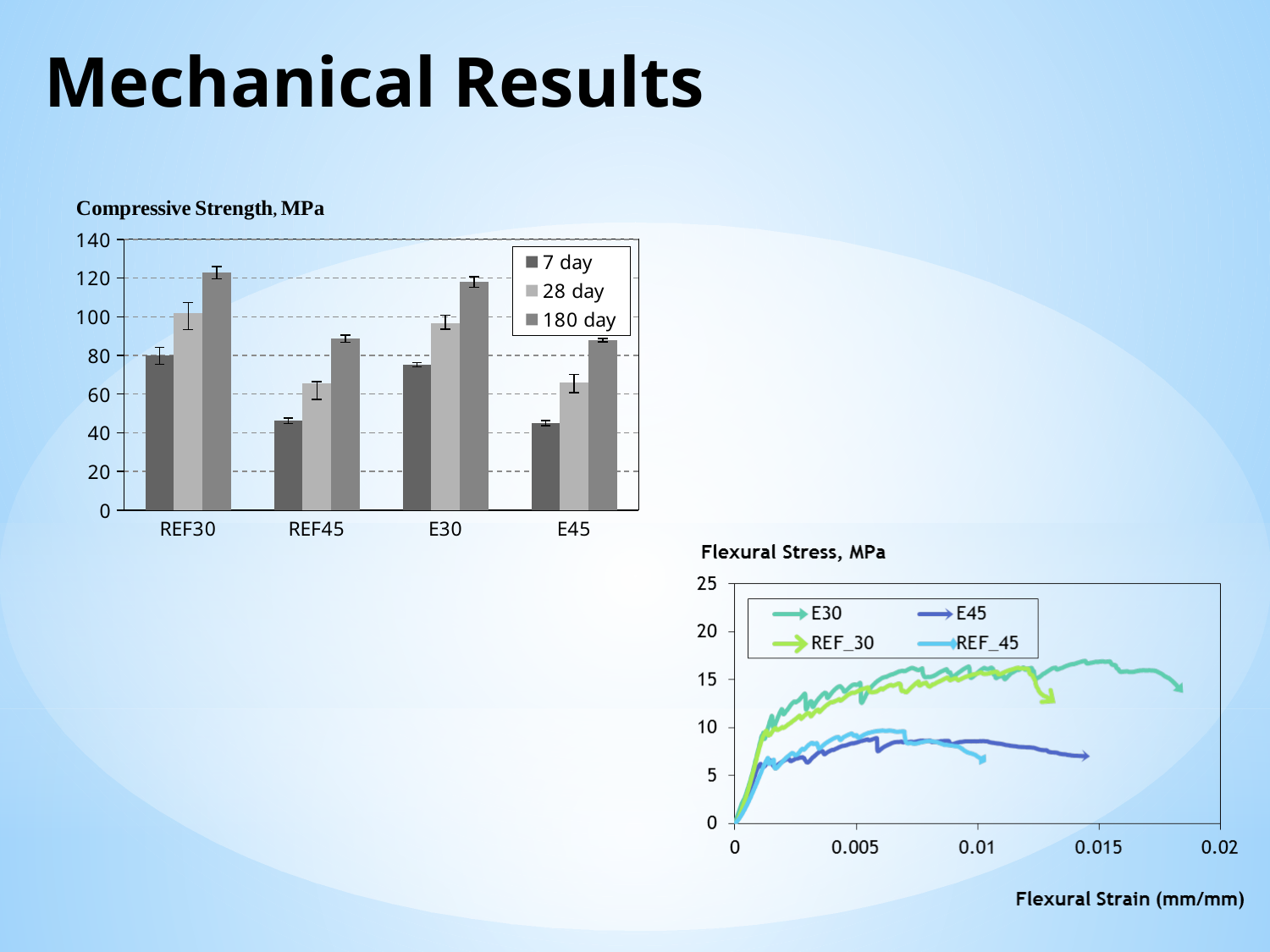
In the Flexural Stress chart, what is the label of the x axis? Flexural Strain (mm/mm) In the Flexural Stress chart, how many series does the legend list? 4 In the Compressive Strength chart, how many categories are shown on the x axis? 4 In the Compressive Strength chart, which category has the highest 180 day value? REF30 In the Compressive Strength chart, is the 7 day value for REF45 greater or less than 60? less In the Compressive Strength chart, is the 28 day value for E30 greater or less than 80? greater In the Flexural Stress chart, what kind of chart is shown? line chart In the Compressive Strength chart, what kind of chart is shown? bar chart In the Compressive Strength chart, how many series does the legend list? 3 In the Compressive Strength chart, is the 180 day value for REF30 greater or less than 120? greater In the Compressive Strength chart, which is larger for E45: the 7 day value or the 180 day value? 180 day